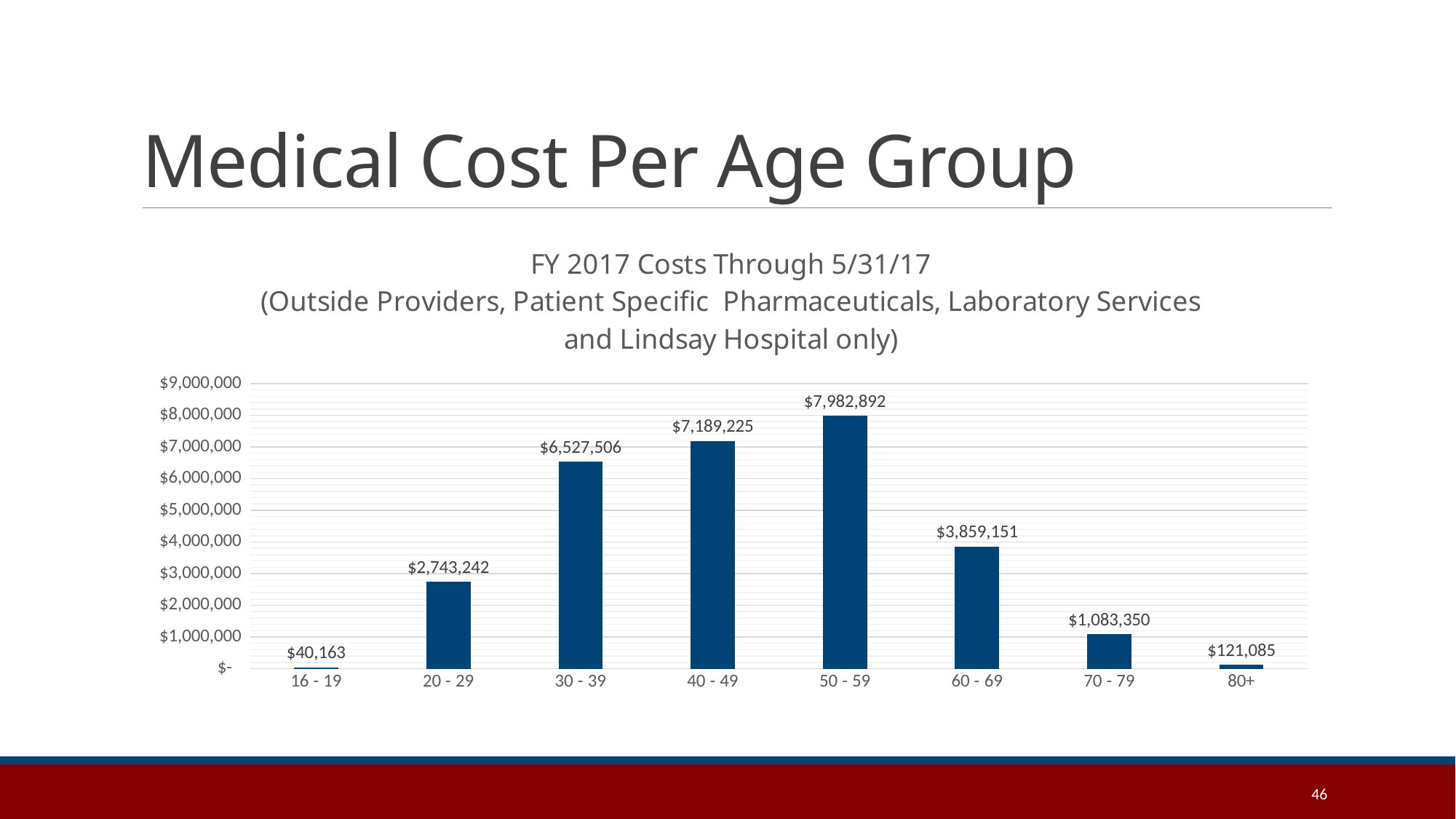
What is the medical cost for the 80+ age group? $121,085 What is the difference in medical cost between the 60 - 69 and 70 - 79 age groups? $2,775,801 Which age group has the lowest medical cost? 16 - 19 Which age group has a larger medical cost, 30 - 39 or 60 - 69? 30 - 39 How many age groups are shown in the chart? 8 Is the medical cost for the 60 - 69 age group greater or less than $3,000,000? greater How much higher is the medical cost for the 50 - 59 age group than for the 40 - 49 age group? $793,667 Which age group has the highest medical cost? 50 - 59 How do the medical costs change across the age groups from 16 - 19 to 80+? They rise to a peak at 50 - 59, then fall What is the medical cost for the 20 - 29 age group? $2,743,242 What is the medical cost for the 50 - 59 age group? $7,982,892 What kind of chart is used to show medical cost per age group? Bar chart